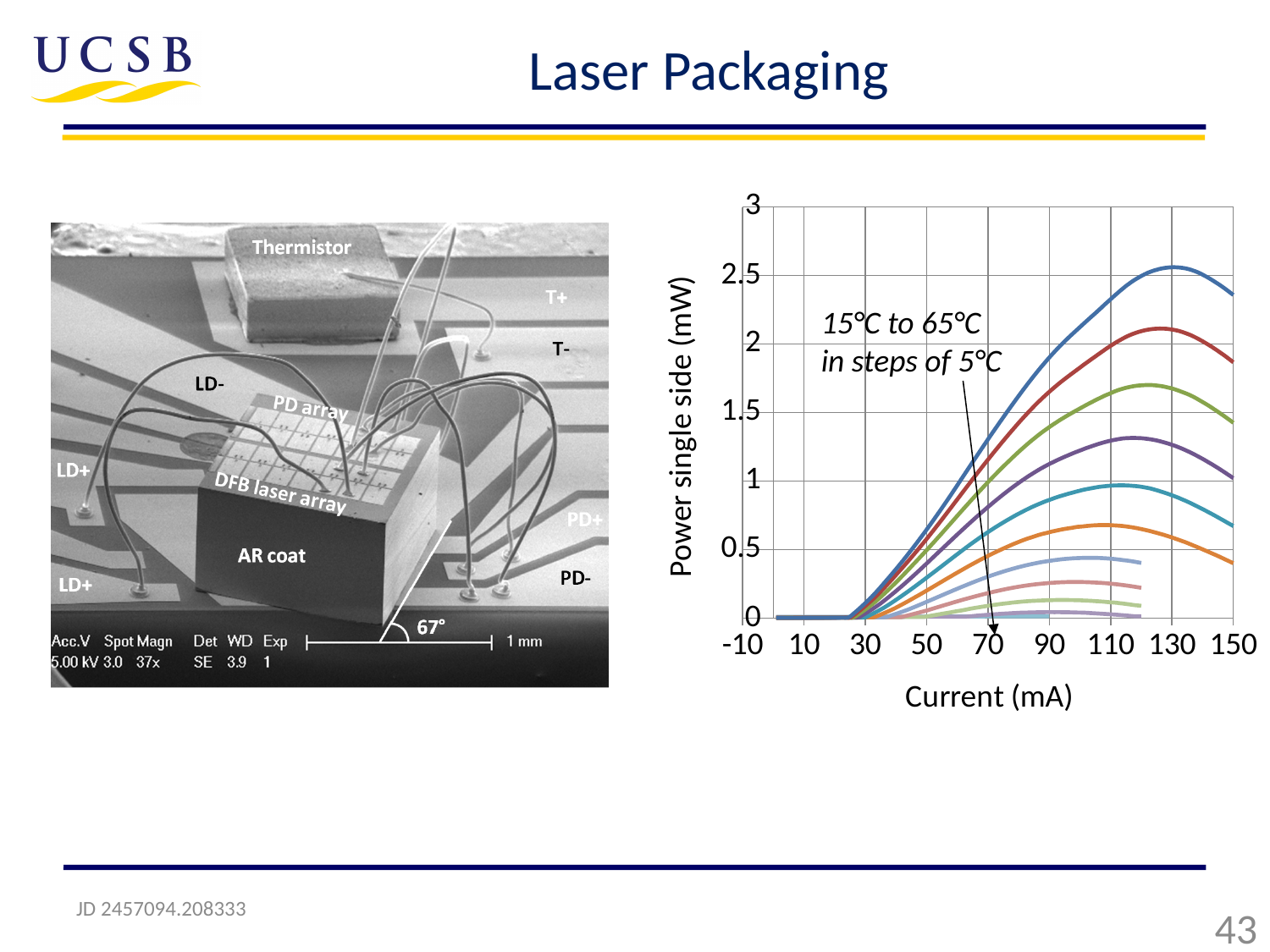
Is the peak power of the topmost curve greater or less than 2 mW? greater Is the power of the topmost curve at 110 mA greater or less than 2 mW? greater What is the power for all curves at a current of 10 mA? 0 What is the title of the x axis of the chart? Current (mA) What is the title of the y axis of the chart? Power single side (mW) Is the peak power of the second-highest (red) curve greater or less than 1.5 mW? greater How many temperature curves are plotted on the chart (15°C to 65°C in steps of 5°C)? 11 Which temperature gives the highest peak power on the chart? 15°C What kind of chart is shown on the right of the slide? line chart Does the power of the topmost curve rise or fall as current increases from 30 mA to 110 mA? rise